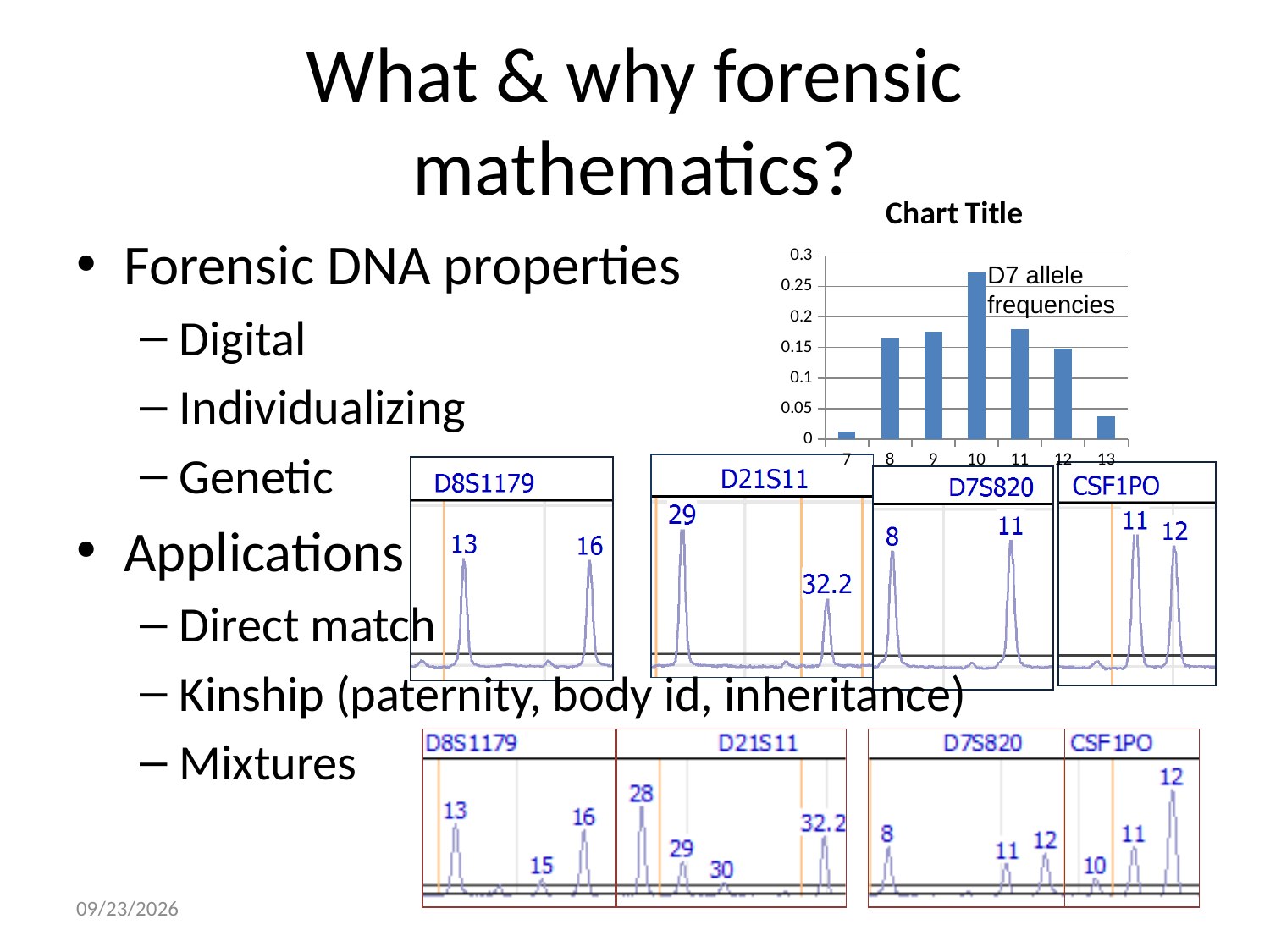
In the bar chart, which is larger, the value for category 13 or the value for category 8? 8 In the bar chart, is the value for category 10 greater or less than 0.25? greater How many categories are shown on the x axis of the bar chart? 7 Which category has the highest bar in the bar chart? 10 Which category has the lowest bar in the bar chart? 7 What is the title shown above the bar chart? Chart Title What text label is placed inside the plot area of the bar chart? D7 allele frequencies In the bar chart, which is larger, the value for category 10 or the value for category 12? 10 In the bar chart, is the value for category 13 greater or less than 0.05? less In the bar chart, is the value for category 12 greater or less than 0.2? less What kind of chart is the chart titled "Chart Title"? bar chart